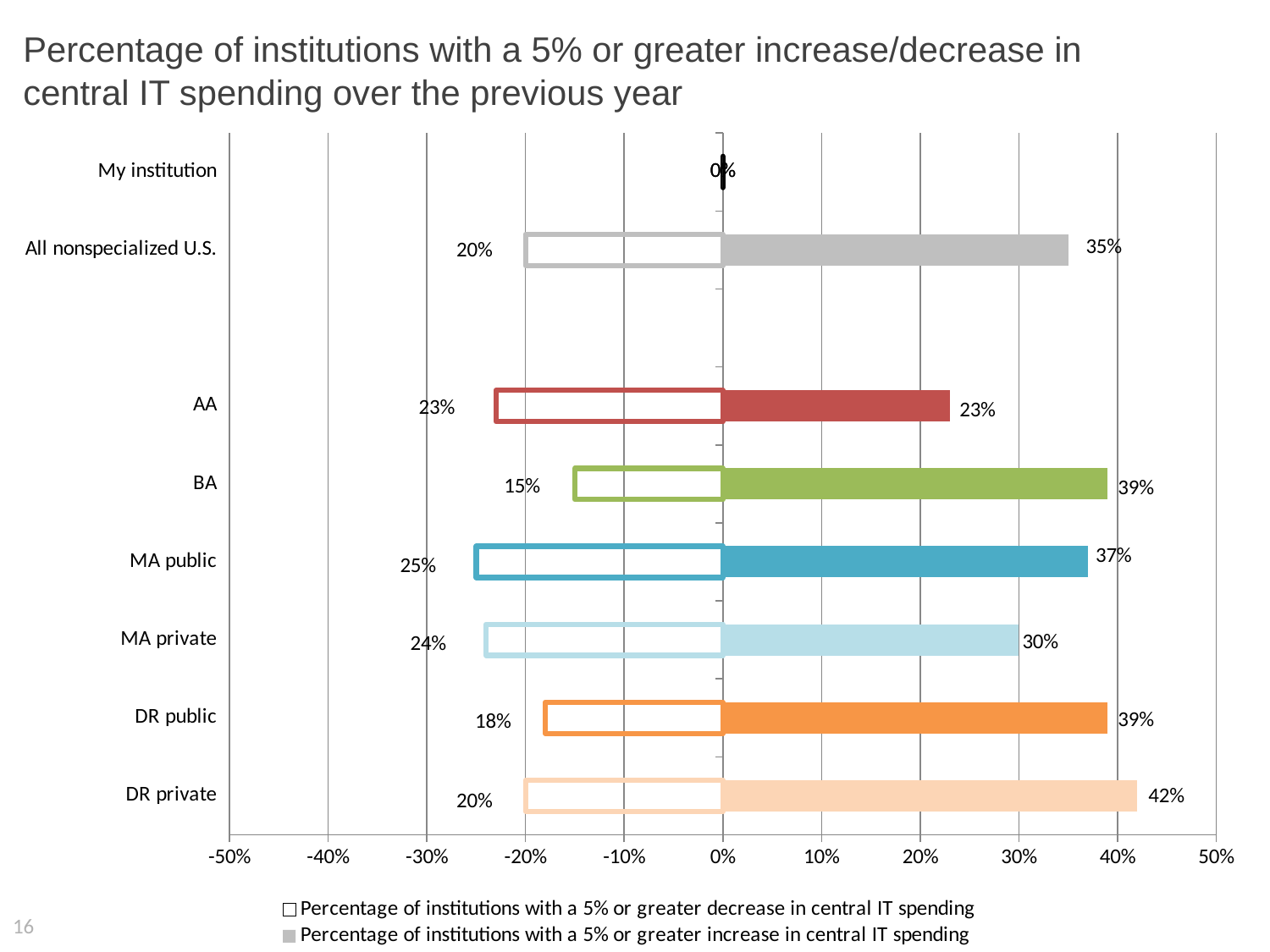
Which institution type has the highest percentage of institutions with a 5% or greater decrease in central IT spending? MA public Which institution type has the lowest percentage of institutions with a 5% or greater decrease in central IT spending? BA How many series does the legend list? 2 What percentage of BA institutions had a 5% or greater decrease in central IT spending? 15% What kind of chart is shown on the slide? Bar chart What value is shown for My institution? 0% What is the value shown for All nonspecialized U.S. institutions with a 5% or greater increase in central IT spending? 35% What percentage of DR private institutions had a 5% or greater increase in central IT spending? 42% Which is larger: the increase percentage for MA public or the increase percentage for MA private? MA public What is the difference between the increase percentage for DR private (42%) and the increase percentage for MA private (30%)? 12% Which institution type has the highest percentage of institutions with a 5% or greater increase in central IT spending? DR private How many institution categories are listed on the vertical axis? 8